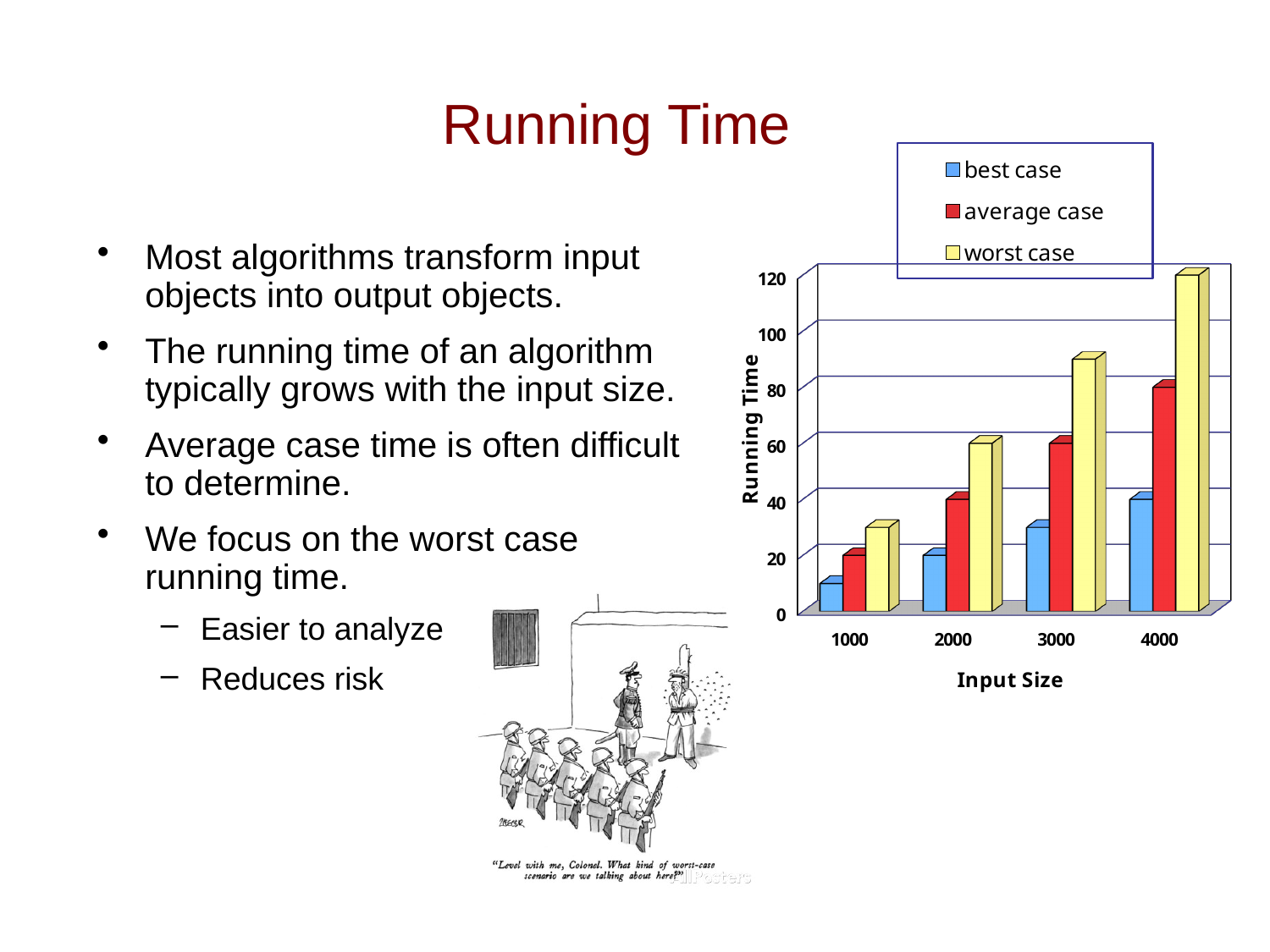
How many series does the chart's legend list? 3 Is the best case running time for input size 1000 greater or less than 20? less Is the worst case running time for input size 4000 greater or less than 100? greater Is the worst case running time for input size 2000 greater or less than 80? less Does the worst case running time rise or fall as input size increases? rise How many input size categories are shown on the x axis of the chart? 4 Which is larger: the average case running time at input size 4000 or the worst case running time at input size 3000? worst case at 3000 What kind of chart is shown on the slide? bar chart Which input size has the lowest best case running time? 1000 What is the label of the y axis of the chart? Running Time Which input size has the highest worst case running time? 4000